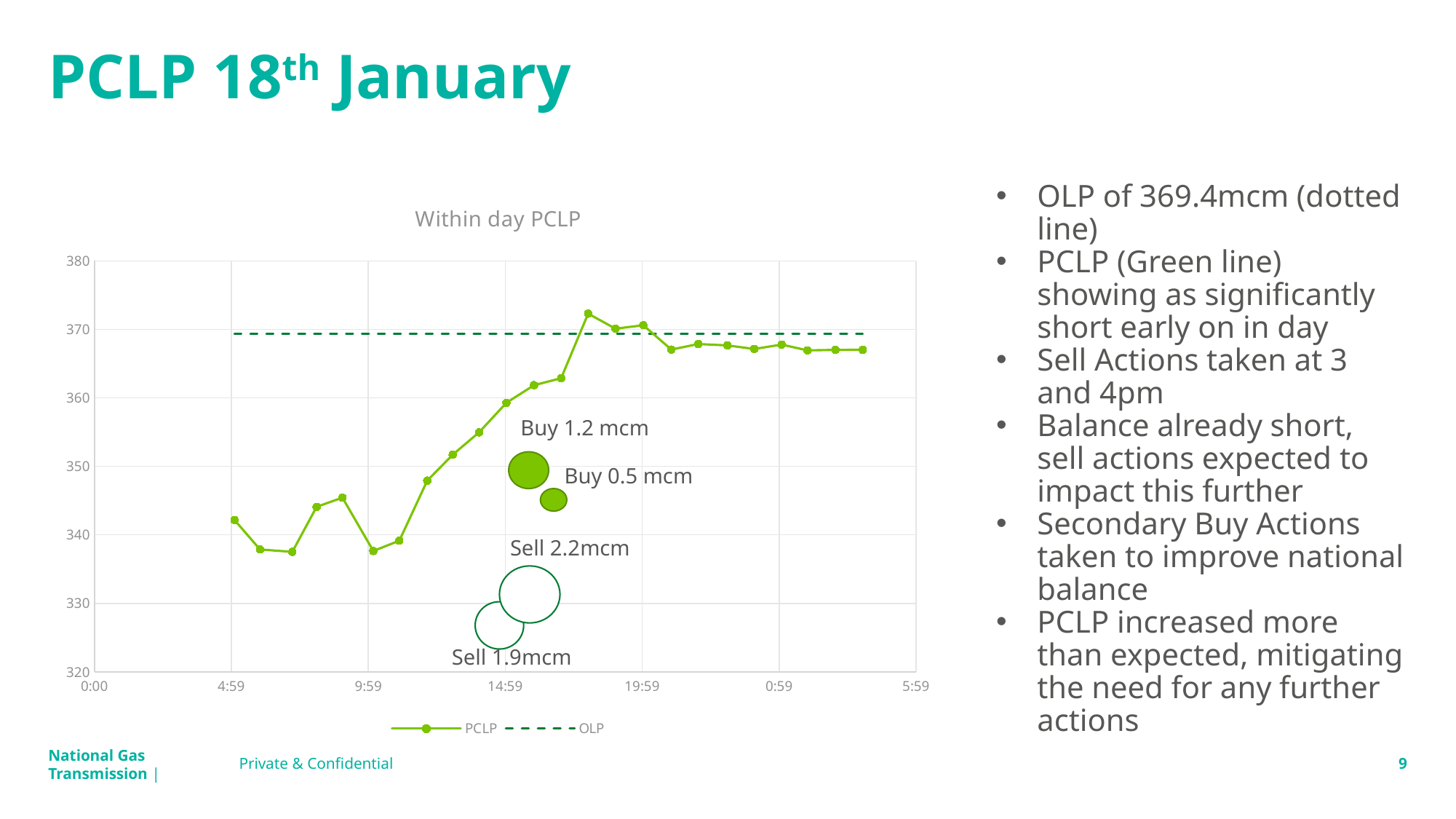
Is the PCLP value at 9:59 greater or less than 340? less How many series does the chart legend list? 2 Which is larger, the PCLP value at 4:59 or the PCLP value at 19:59? 19:59 Is the PCLP value at 14:59 greater or less than 350? greater Is the PCLP value at 19:59 greater or less than 360? greater According to the slide text, what is the OLP value shown by the dotted line? 369.4mcm What is the title of the chart? Within day PCLP What volume is annotated on the larger sell action bubble? Sell 2.2mcm Does the PCLP line rise or fall between 9:59 and 19:59? rise What kind of chart is shown on the slide? line chart